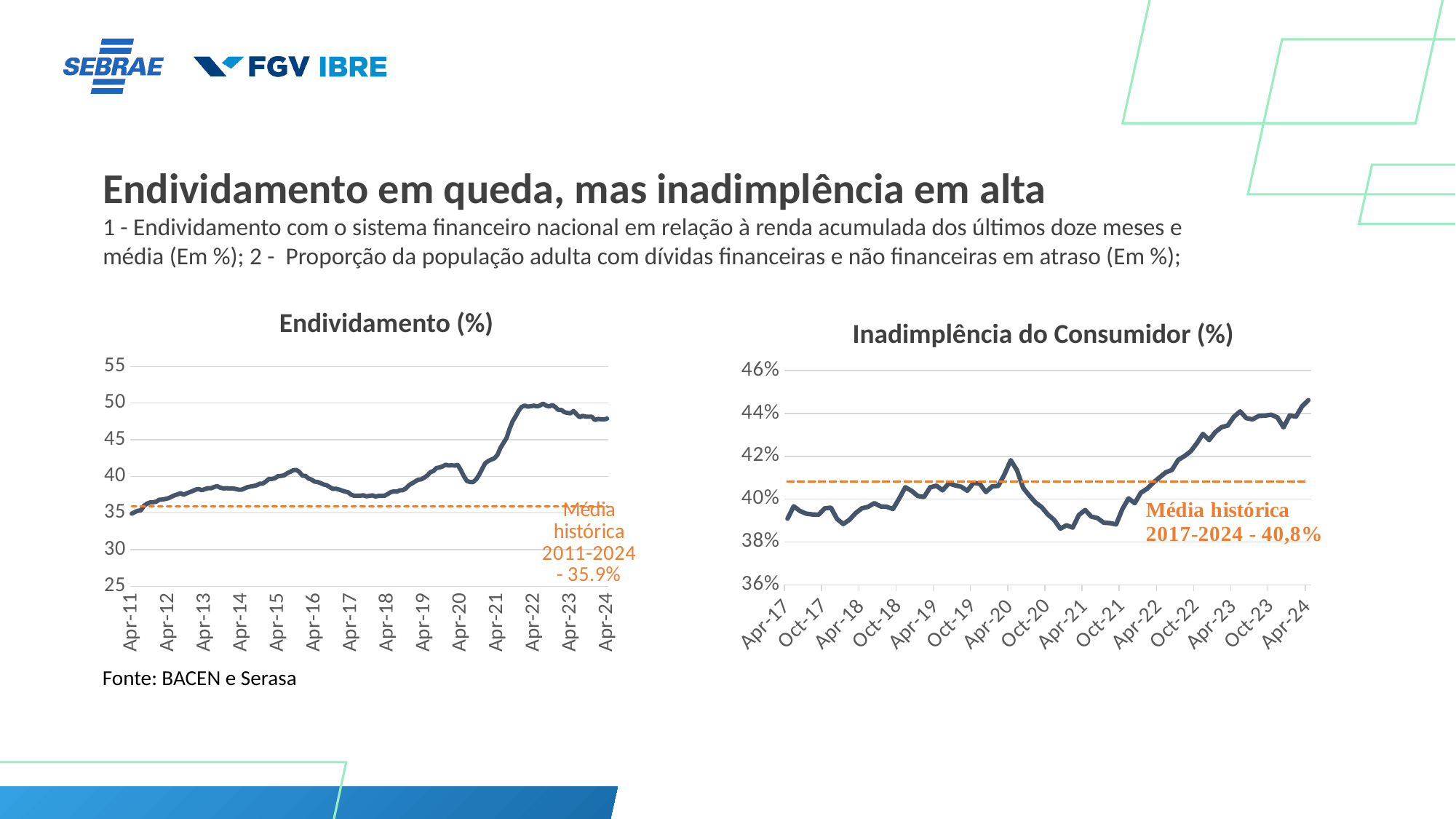
In the 'Inadimplência do Consumidor (%)' chart, is the value at Apr-24 greater or less than 44%? greater In the 'Endividamento (%)' chart, which is higher: the value at Apr-22 or the value at Apr-17? Apr-22 What kind of chart is the 'Inadimplência do Consumidor (%)' chart on the right? line chart In the 'Endividamento (%)' chart, do values generally rise or fall from Apr-22 to Apr-24? fall In the 'Inadimplência do Consumidor (%)' chart, is the value at Apr-17 greater or less than 40%? less In the 'Endividamento (%)' chart, is the value at Apr-11 greater or less than 40? less In the 'Inadimplência do Consumidor (%)' chart, which is higher: the value at Apr-24 or the value at Apr-21? Apr-24 In the 'Inadimplência do Consumidor (%)' chart, what is the historical average for 2017-2024 shown by the dashed line? 40,8% In the 'Inadimplência do Consumidor (%)' chart, do values generally rise or fall from Apr-21 to Apr-24? rise In the 'Endividamento (%)' chart, what is the historical average for 2011-2024 shown by the dashed line? 35.9% What kind of chart is the 'Endividamento (%)' chart on the left? line chart